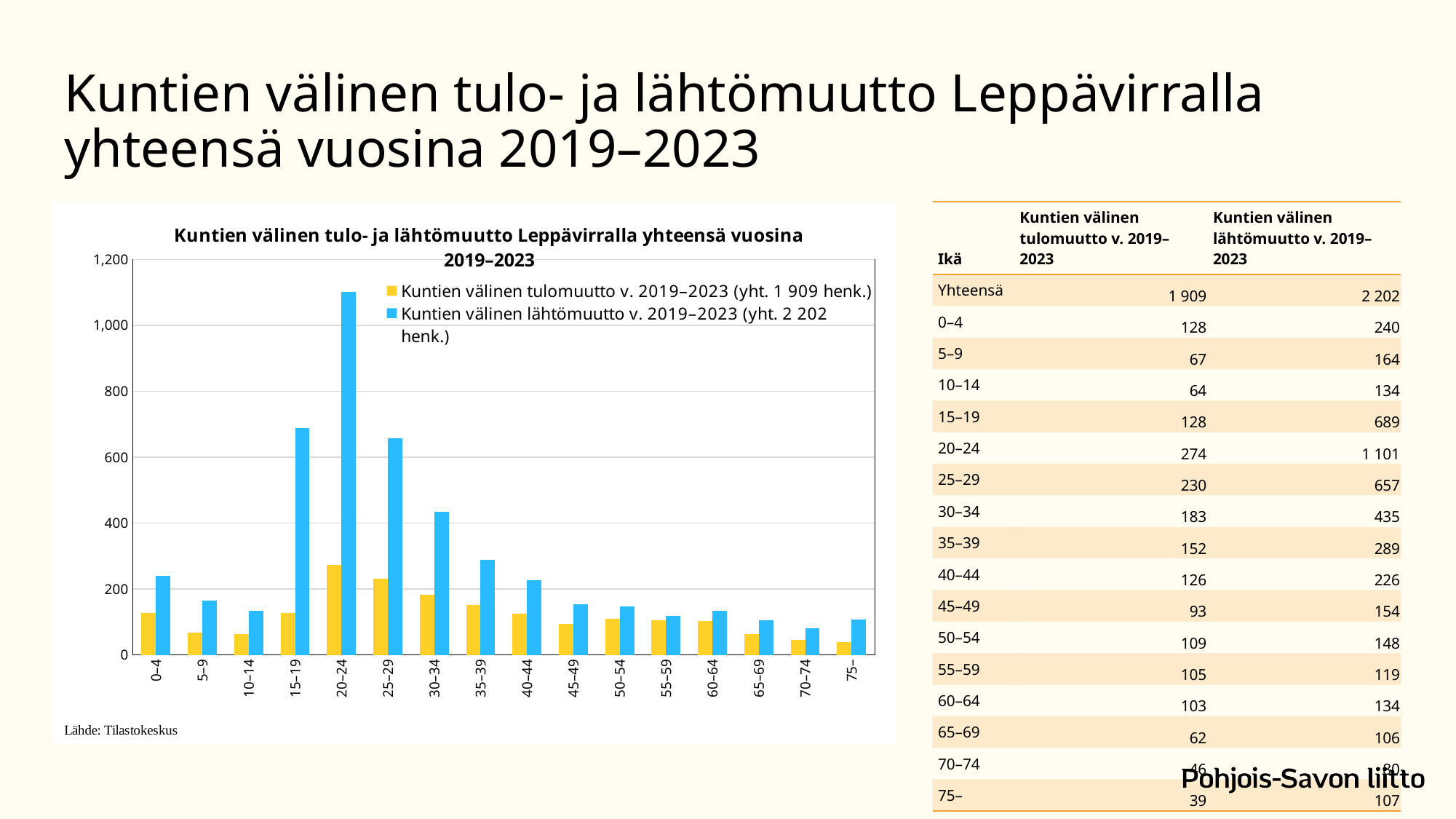
How many series does the chart's legend list? 2 How many age groups are shown on the x axis of the chart? 16 For the 25–29 age group, which is larger: tulomuutto or lähtömuutto? lähtömuutto Which age group has the highest value for Kuntien välinen tulomuutto v. 2019–2023? 20–24 Is the tulomuutto value for the 20–24 age group greater or less than 400? less Which age group has the highest value for Kuntien välinen lähtömuutto v. 2019–2023? 20–24 Is the lähtömuutto value for the 15–19 age group greater or less than 600? greater Which age group has the lowest value for Kuntien välinen lähtömuutto v. 2019–2023? 70–74 What is the difference between the total lähtömuutto (2 202) and the total tulomuutto (1 909) shown in the legend? 293 What colour are the bars for Kuntien välinen tulomuutto v. 2019–2023? yellow According to the legend, what is the total number of people for Kuntien välinen tulomuutto v. 2019–2023? 1 909 henk. What kind of chart is shown on the slide? bar chart